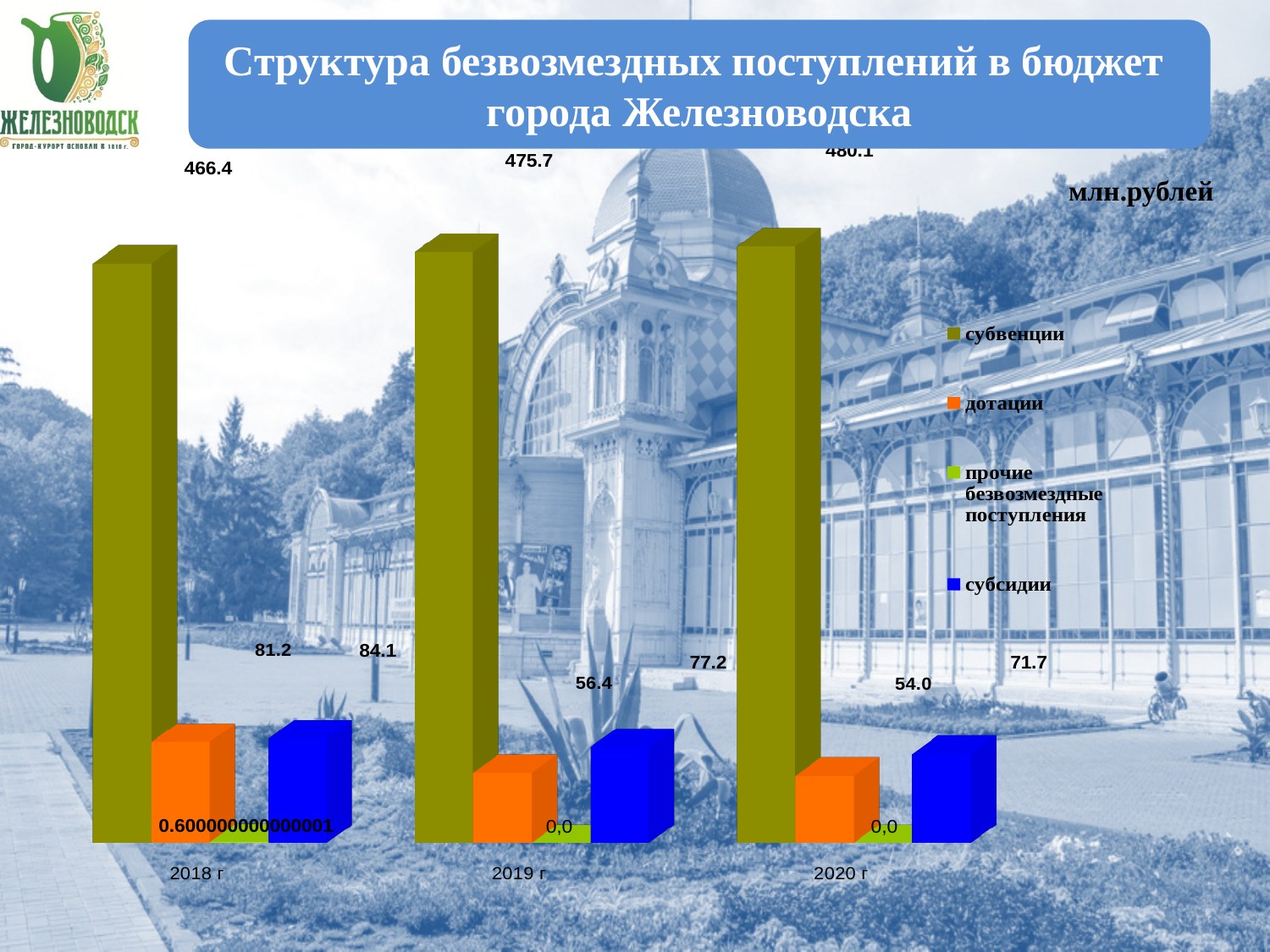
What is the value of субвенции for 2019 г? 475.7 Which is larger in 2018 г: дотации or субсидии? субсидии What is the value of субсидии for 2020 г? 71.7 What is the value of субвенции for 2018 г? 466.4 What unit is stated for the values on the chart? млн.рублей What type of chart is shown on the slide? bar chart Do the дотации values rise or fall from 2018 г to 2020 г? fall What is the value of дотации for 2018 г? 81.2 How many years (categories) are shown on the x axis? 3 How many series does the legend list? 4 What is the difference between субсидии and дотации in 2019 г? 20.8 What is the value of дотации for 2020 г? 54.0